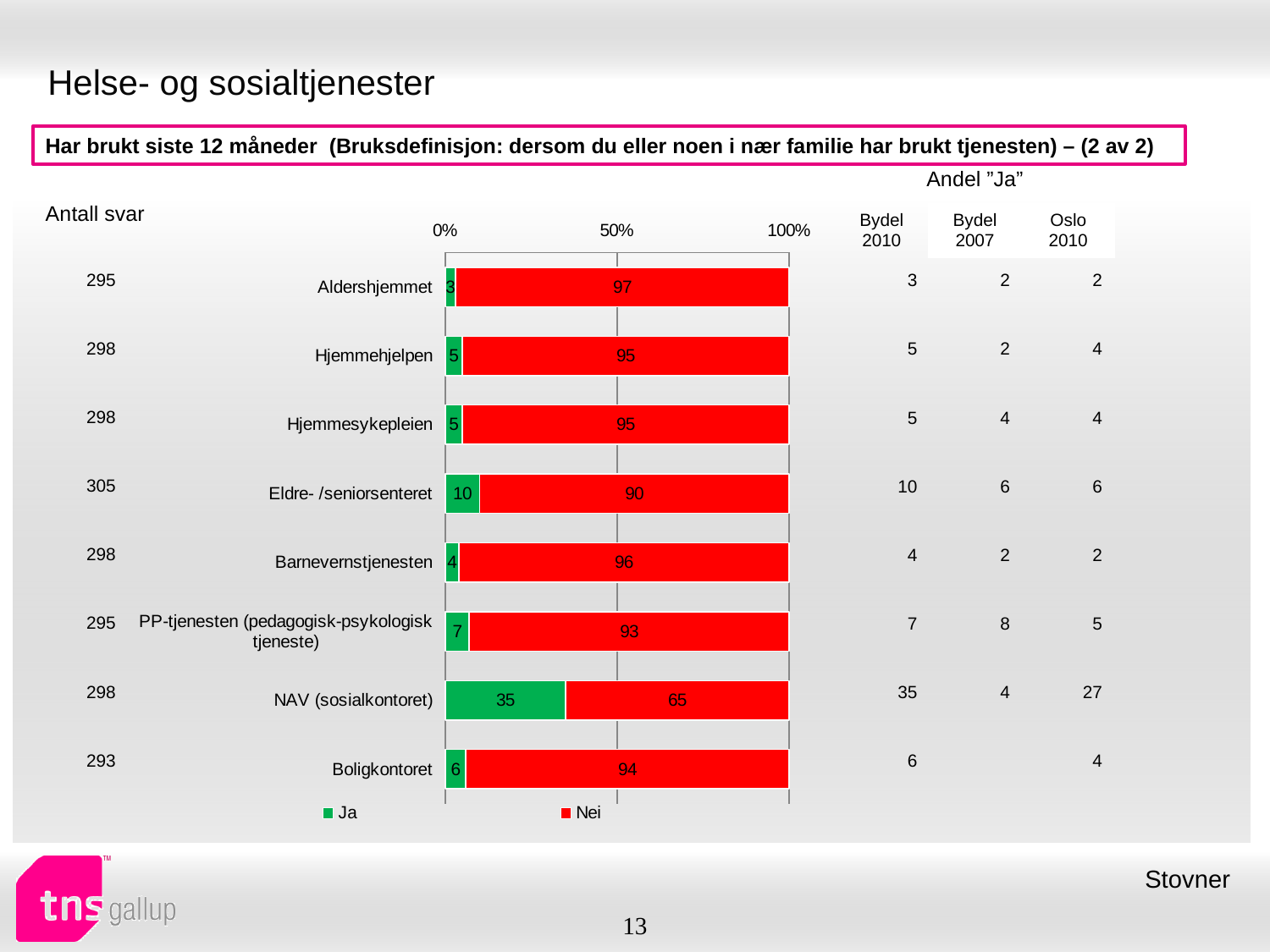
Is the "Nei" value for NAV (sosialkontoret) greater or less than 50%? greater What kind of chart is shown on the slide? Stacked bar chart Which category has the lowest "Ja" value? Aldershjemmet How many categories are shown in the chart? 8 How many series does the legend list? 2 Which category has the highest "Ja" value? NAV (sosialkontoret) What is the "Nei" value for Aldershjemmet? 97 Which is larger, the "Ja" value for PP-tjenesten (pedagogisk-psykologisk tjeneste) or for Boligkontoret? PP-tjenesten (pedagogisk-psykologisk tjeneste) What is the total of the stacked bar for Hjemmehjelpen? 100 What is the difference between the "Nei" values for Aldershjemmet and NAV (sosialkontoret)? 32 What is the "Ja" value for NAV (sosialkontoret)? 35 What is the "Ja" value for Eldre- /seniorsenteret? 10